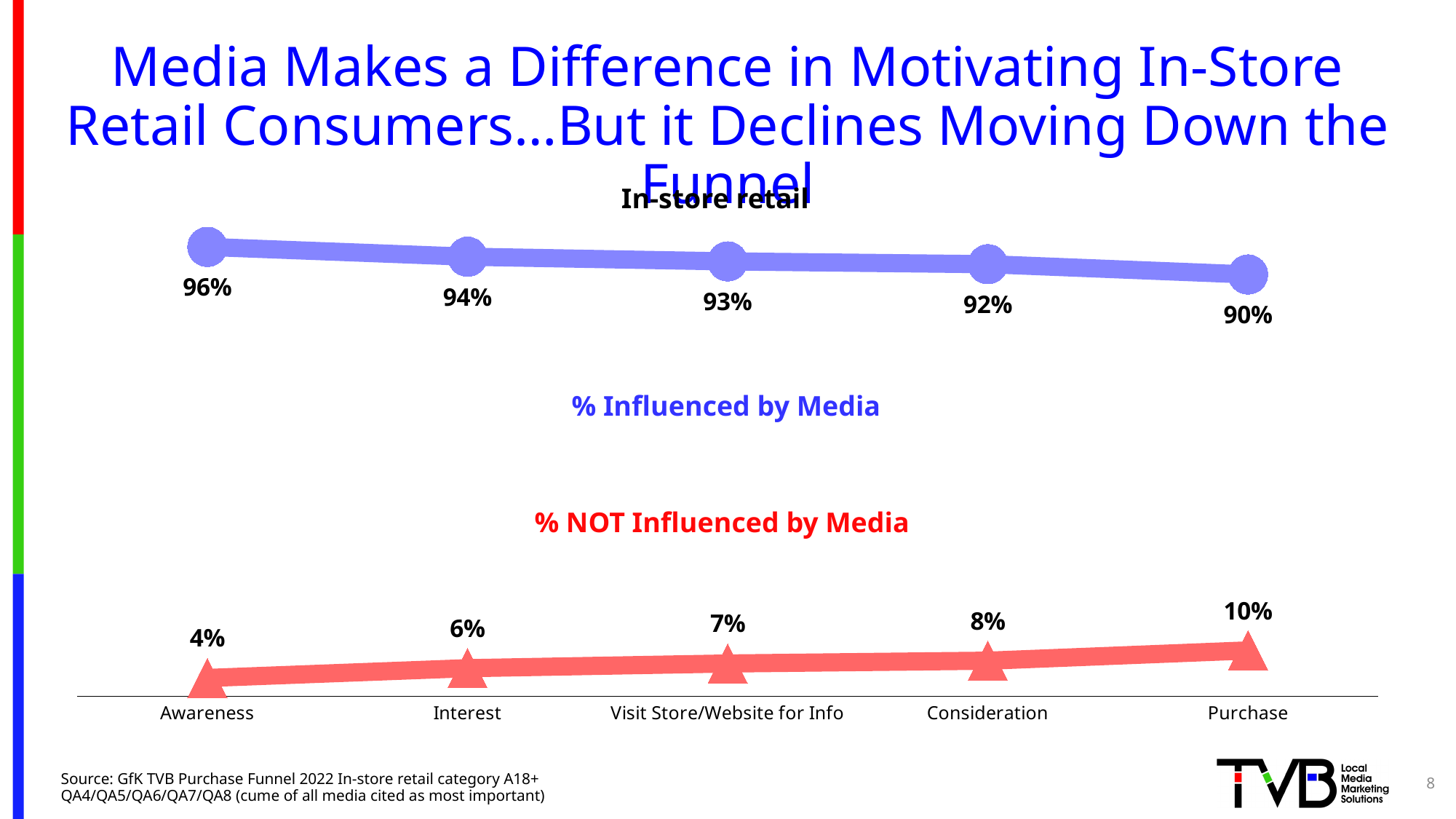
Which funnel stage has the lowest % NOT Influenced by Media value? Awareness What kind of chart is shown on the slide? Line chart What is the % Influenced by Media value for Awareness? 96% How many funnel stages are shown on the x axis? 5 What is the % NOT Influenced by Media value for Visit Store/Website for Info? 7% Which funnel stage has the highest % Influenced by Media value? Awareness Does the % Influenced by Media series rise or fall moving from Awareness to Purchase? Fall What is the difference between the % Influenced by Media values for Awareness and Purchase? 6% What is the title of the chart? In-store retail What is the % NOT Influenced by Media value for Purchase? 10% Which is larger: the % NOT Influenced by Media value for Interest or for Consideration? Consideration What is the % Influenced by Media value for Consideration? 92%